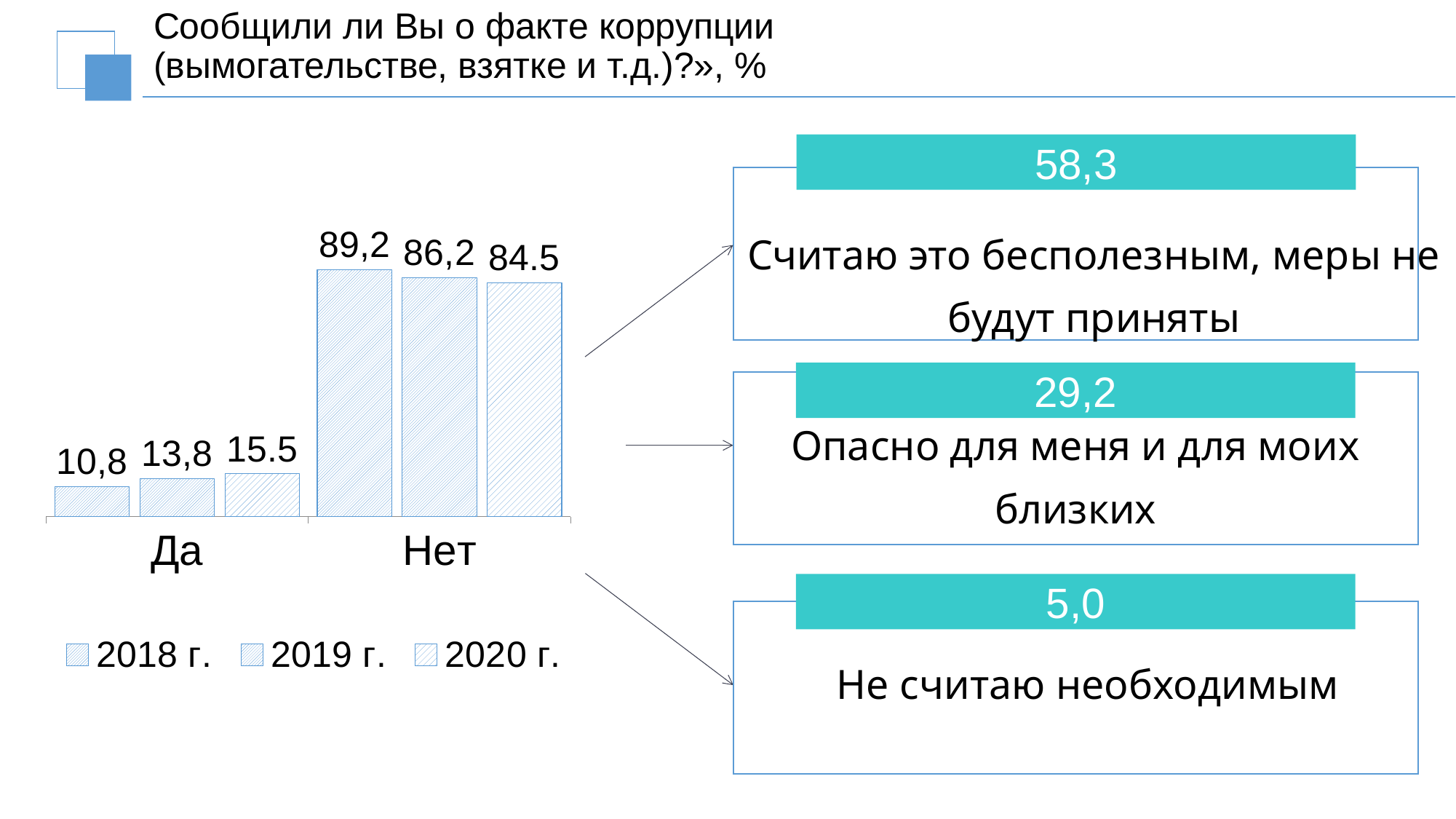
How many series does the legend list? 3 How many categories are shown on the x axis? 2 What is the value for "Нет" in 2019 г.? 86,2 Which year has the lowest value for "Да"? 2018 г. What is the value for "Да" in 2020 г.? 15.5 What is the value for "Да" in 2018 г.? 10,8 What is the difference between the "Нет" values for 2018 г. and 2019 г.? 3,0 Which year has the highest value for "Нет"? 2018 г. Do the "Да" values rise or fall from 2018 г. to 2020 г.? rise What type of chart is shown on the slide? bar chart Which is larger: the "Да" value for 2019 г. or for 2020 г.? 2020 г. What is the value for "Нет" in 2020 г.? 84.5